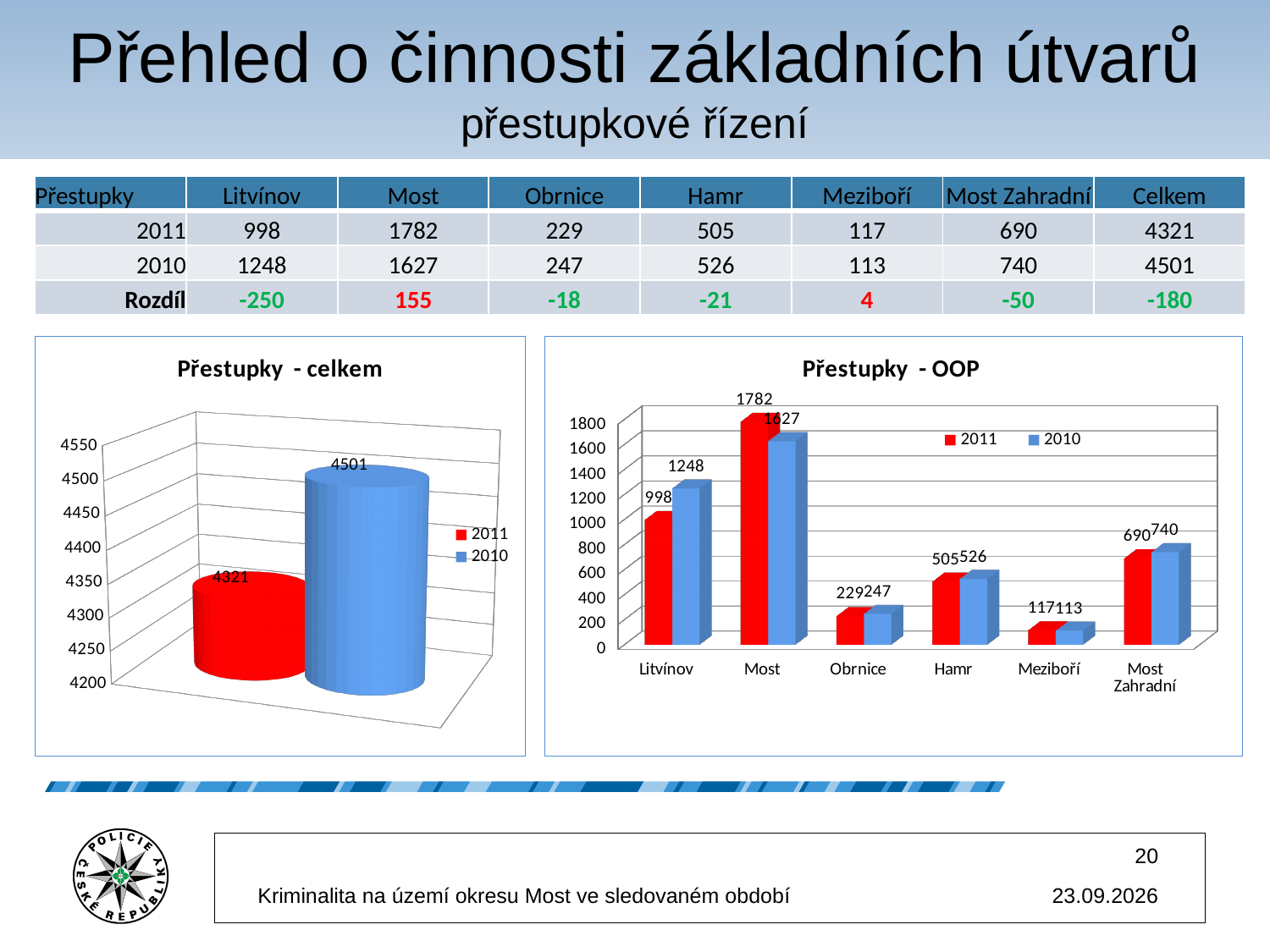
What kind of chart is the 'Přestupky - OOP' chart? Bar chart In the 'Přestupky - OOP' chart, what is the difference between the 2010 and 2011 values for Most Zahradní? 50 In the 'Přestupky - OOP' chart, what is the 2011 value for Most? 1782 In the 'Přestupky - celkem' chart, what is the value for 2010? 4501 In the 'Přestupky - OOP' chart, which category has the highest 2011 value? Most In the 'Přestupky - OOP' chart, which category has the lowest 2010 value? Meziboří In the 'Přestupky - celkem' chart, which year has the larger value, 2011 or 2010? 2010 In the 'Přestupky - celkem' chart, what is the value for 2011? 4321 In the 'Přestupky - OOP' chart, what is the 2010 value for Litvínov? 1248 How many categories are shown on the x axis of the 'Přestupky - OOP' chart? 6 How many series does the legend of the 'Přestupky - OOP' chart list? 2 In the 'Přestupky - celkem' chart, what is the difference between the 2010 and 2011 values? 180